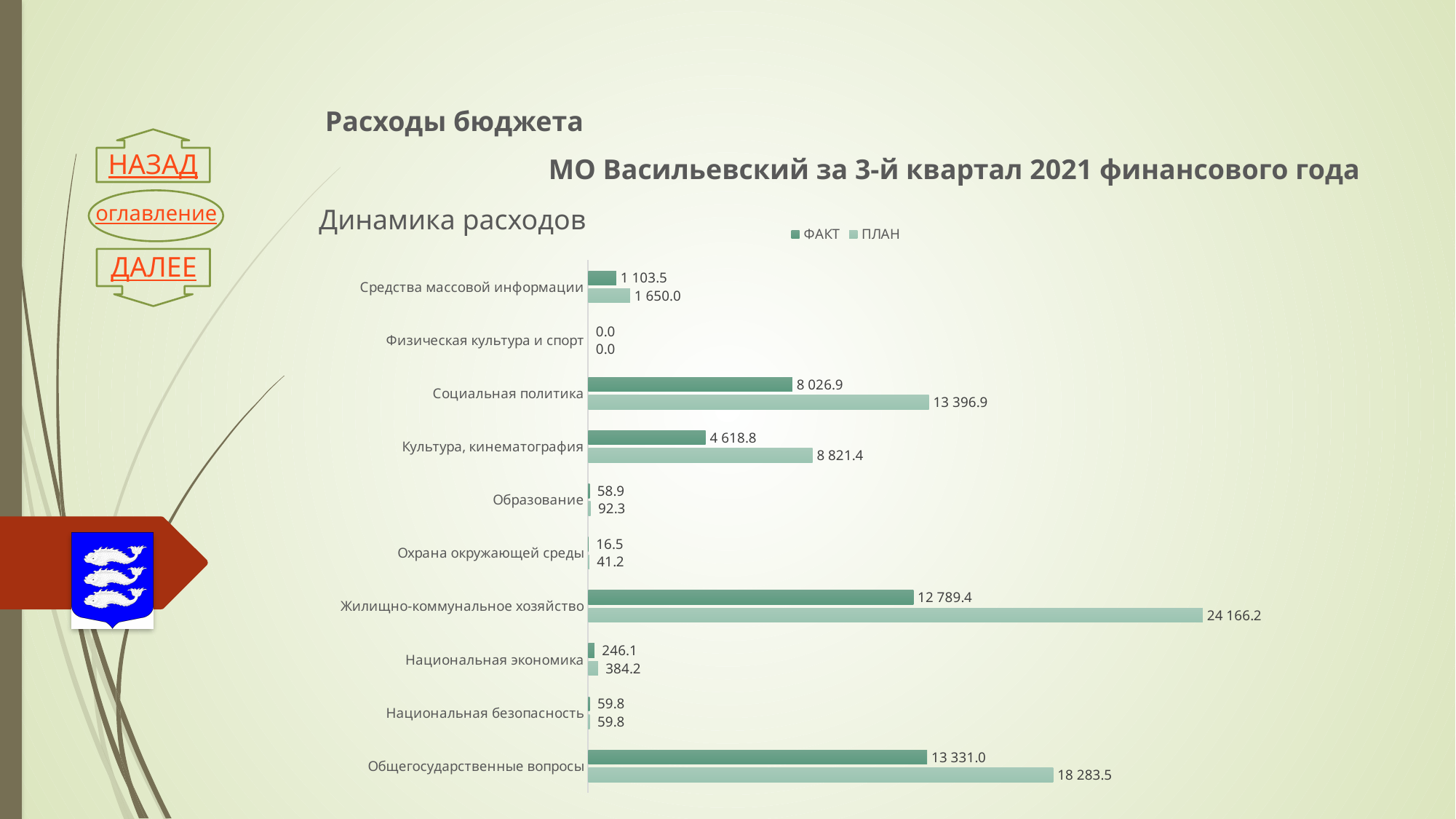
What is the ФАКТ value for Социальная политика? 8 026.9 What is the difference between the ПЛАН and ФАКТ values for Общегосударственные вопросы? 4 952.5 How many series does the legend list? 2 Which category has the highest ПЛАН value? Жилищно-коммунальное хозяйство What is the ПЛАН value for Жилищно-коммунальное хозяйство? 24 166.2 What are the two series named in the legend? ФАКТ and ПЛАН Which is larger for Национальная экономика: the ФАКТ value or the ПЛАН value? ПЛАН How many categories are shown on the chart? 10 What is the ПЛАН value for Культура, кинематография? 8 821.4 What is the difference between the ПЛАН and ФАКТ values for Жилищно-коммунальное хозяйство? 11 376.8 Which category has the highest ФАКТ value? Общегосударственные вопросы What kind of chart is shown on the slide? bar chart